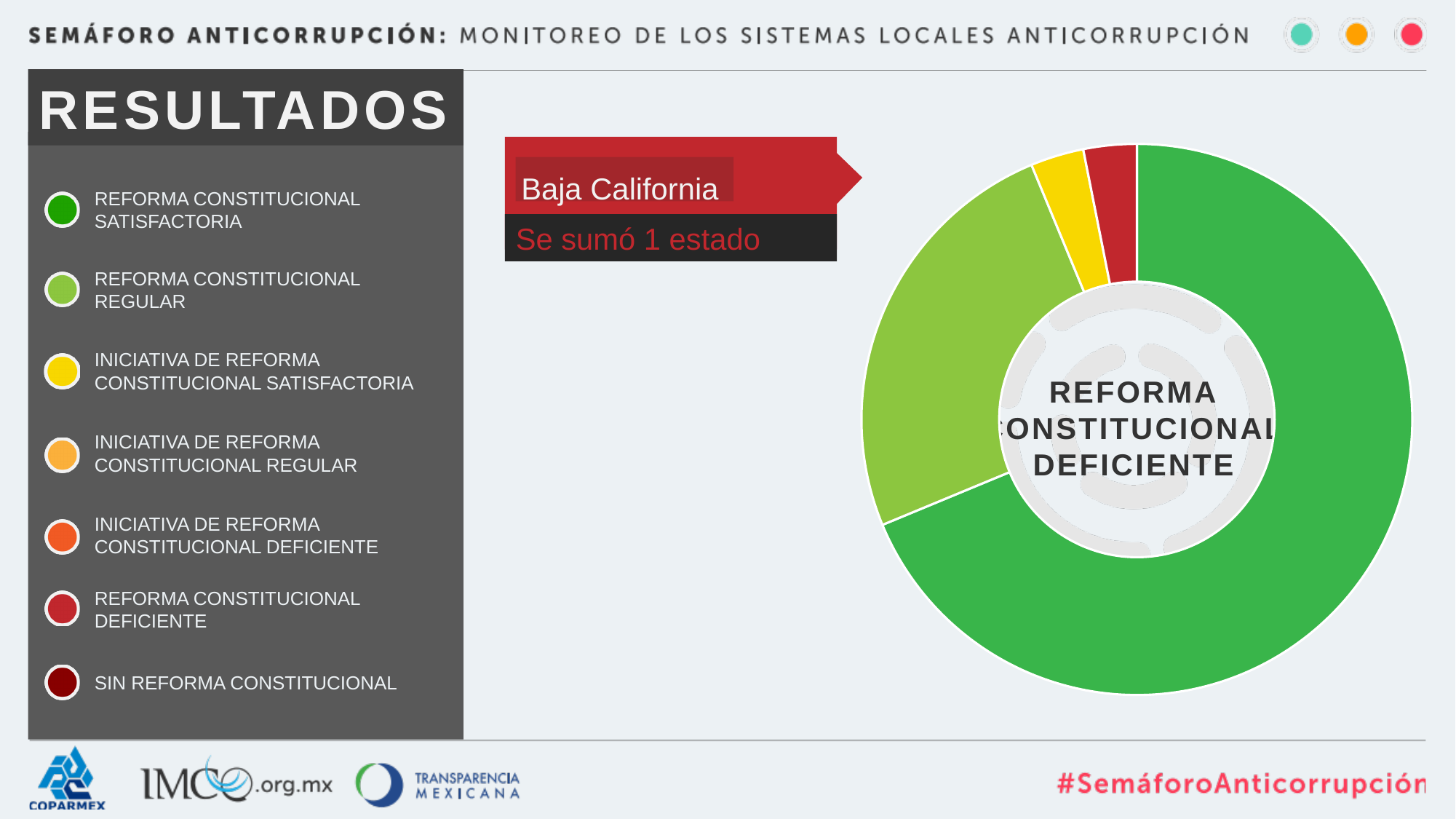
Is the share of the dark green slice (Reforma constitucional satisfactoria) greater or less than 50% of the pie? greater What text is written in the centre of the pie chart? REFORMA CONSTITUCIONAL DEFICIENTE Which slice is larger in the pie chart: the dark green one (Reforma constitucional satisfactoria) or the light green one (Reforma constitucional regular)? Dark green (Reforma constitucional satisfactoria) Which slice is larger in the pie chart: the light green one (Reforma constitucional regular) or the yellow one (Iniciativa de reforma constitucional satisfactoria)? Light green (Reforma constitucional regular) How many slices does the pie chart contain? 4 Which category has the largest slice in the pie chart? Reforma constitucional satisfactoria Which state is named in the red callout next to the pie chart? Baja California What kind of chart is shown on the right side of the slide? Doughnut chart How many categories does the legend on the left of the slide list? 7